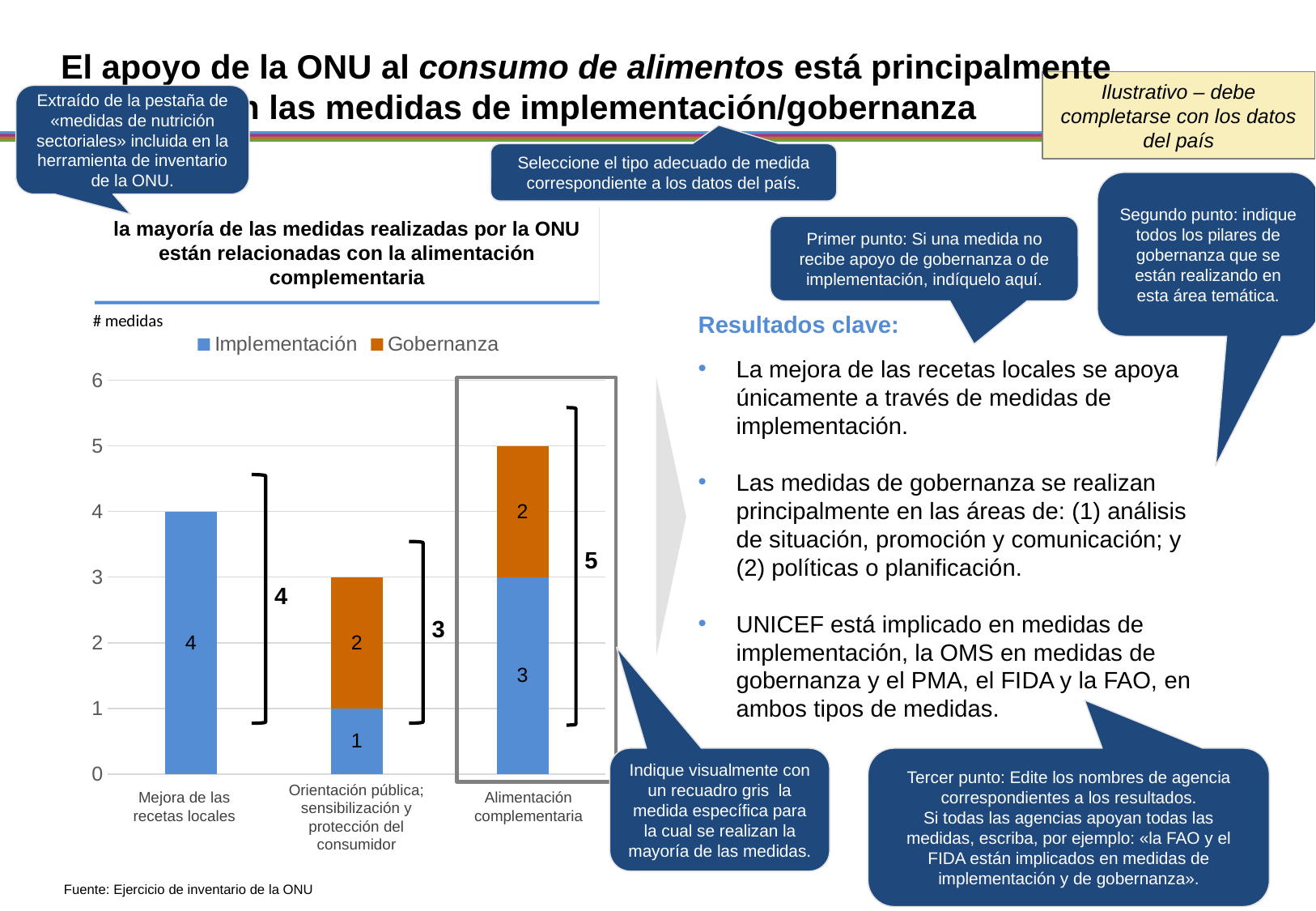
Which category has the lowest total number of measures? Orientación pública; sensibilización y protección del consumidor Which series is shown in orange in the chart legend? Gobernanza How many series does the chart legend list? 2 What is the Gobernanza value for Orientación pública; sensibilización y protección del consumidor? 2 What is the Implementación value for Mejora de las recetas locales? 4 What is the total number of measures for Alimentación complementaria? 5 What is the difference between the Implementación value for Mejora de las recetas locales and the Implementación value for Orientación pública; sensibilización y protección del consumidor? 3 What is the total number of measures for Orientación pública; sensibilización y protección del consumidor? 3 What is the Implementación value for Alimentación complementaria? 3 What kind of chart is shown on the slide? Stacked bar chart Which category has the highest total number of measures? Alimentación complementaria How many categories are shown on the x axis of the chart? 3